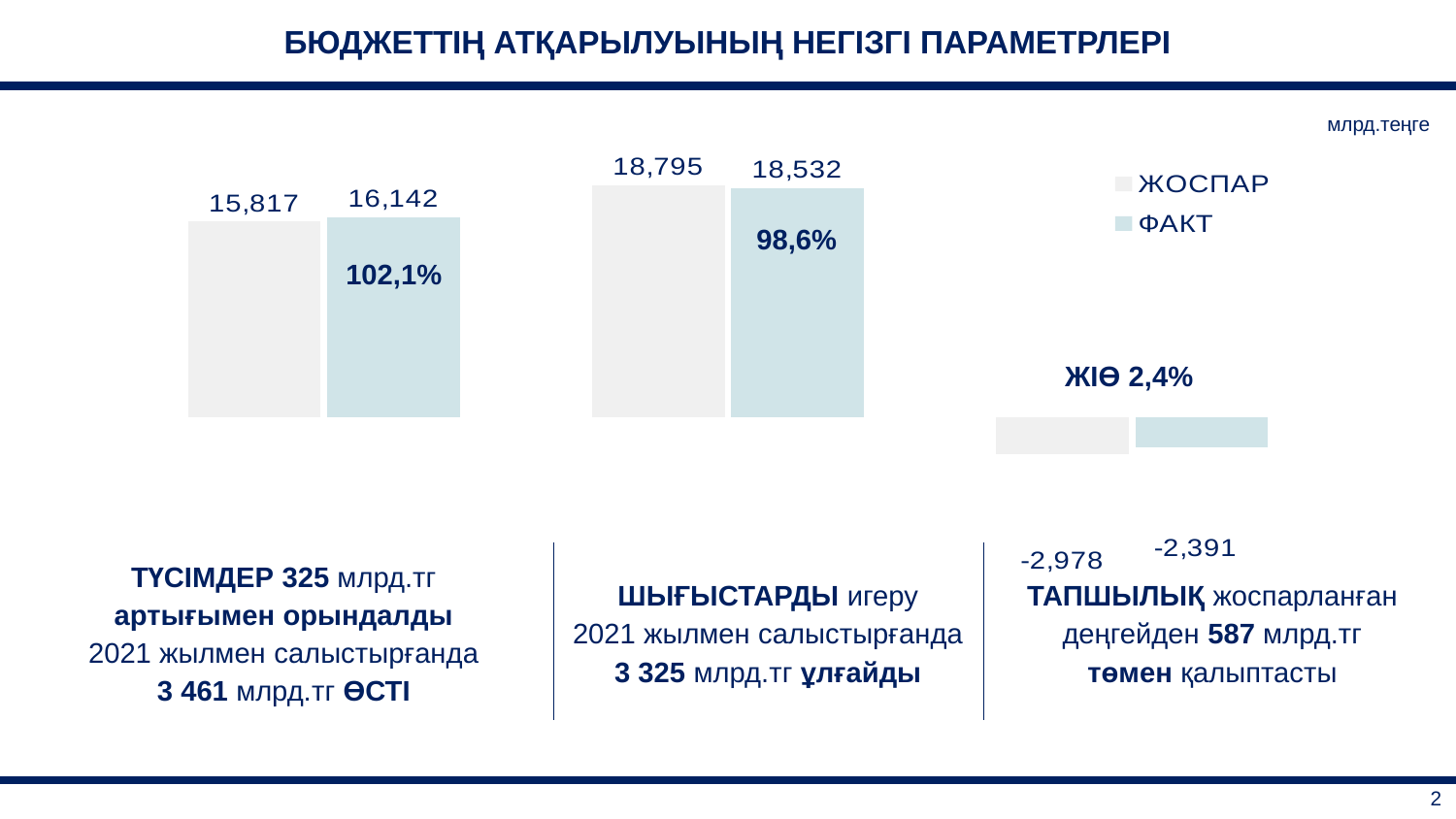
What type of chart is the left chart? Bar chart On the right chart, what is the value of the ФАКТ bar? -2,391 On the middle chart, what is the difference between the ЖОСПАР and ФАКТ values? 263 On the right chart, what is the value of the ЖОСПАР bar? -2,978 On the left chart, what is the difference between the ФАКТ and ЖОСПАР values? 325 How many series does the legend on the slide list? 2 On the left chart, what is the value of the ЖОСПАР bar? 15,817 On the left chart, what is the value of the ФАКТ bar? 16,142 On the middle chart, what is the value of the ФАКТ bar? 18,532 On the left chart, which bar is larger, ЖОСПАР or ФАКТ? ФАКТ On the middle chart, which bar is larger, ЖОСПАР or ФАКТ? ЖОСПАР On the middle chart, what is the value of the ЖОСПАР bar? 18,795